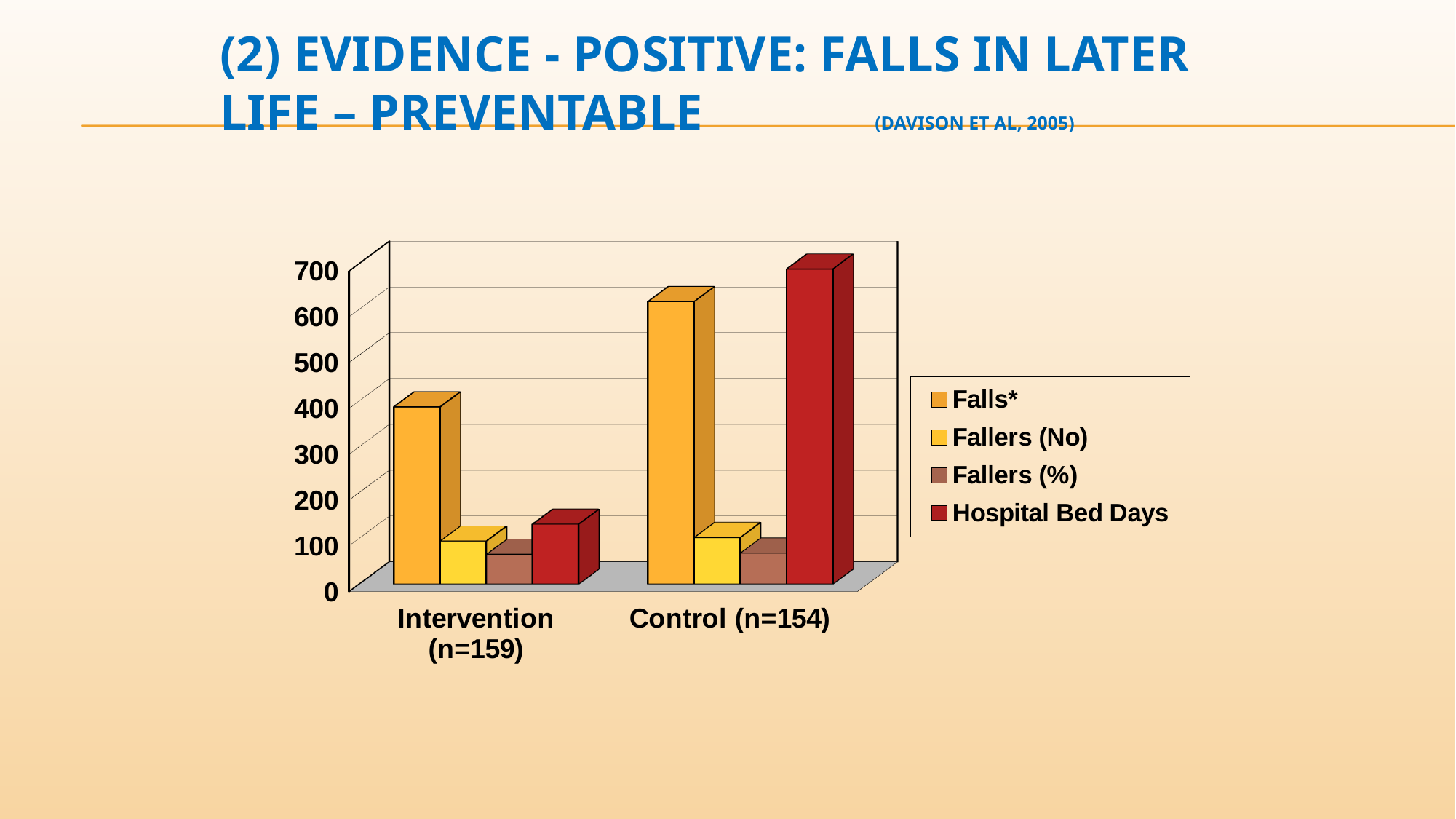
How many series does the legend list? 4 Which series is shown in dark red in the legend? Hospital Bed Days Is the Hospital Bed Days value for Intervention (n=159) greater or less than 200? less Is the Falls* value for Intervention (n=159) greater or less than 300? greater What kind of chart is shown on the slide? Bar chart Which group has the larger Hospital Bed Days value, Intervention (n=159) or Control (n=154)? Control (n=154) Which series has the tallest bar in the Control (n=154) group? Hospital Bed Days Which series has the tallest bar in the Intervention (n=159) group? Falls* Which series has the shortest bar in the Intervention (n=159) group? Fallers (%) How many groups (categories) are shown on the x axis? 2 Is the Hospital Bed Days value for Control (n=154) greater or less than 600? greater